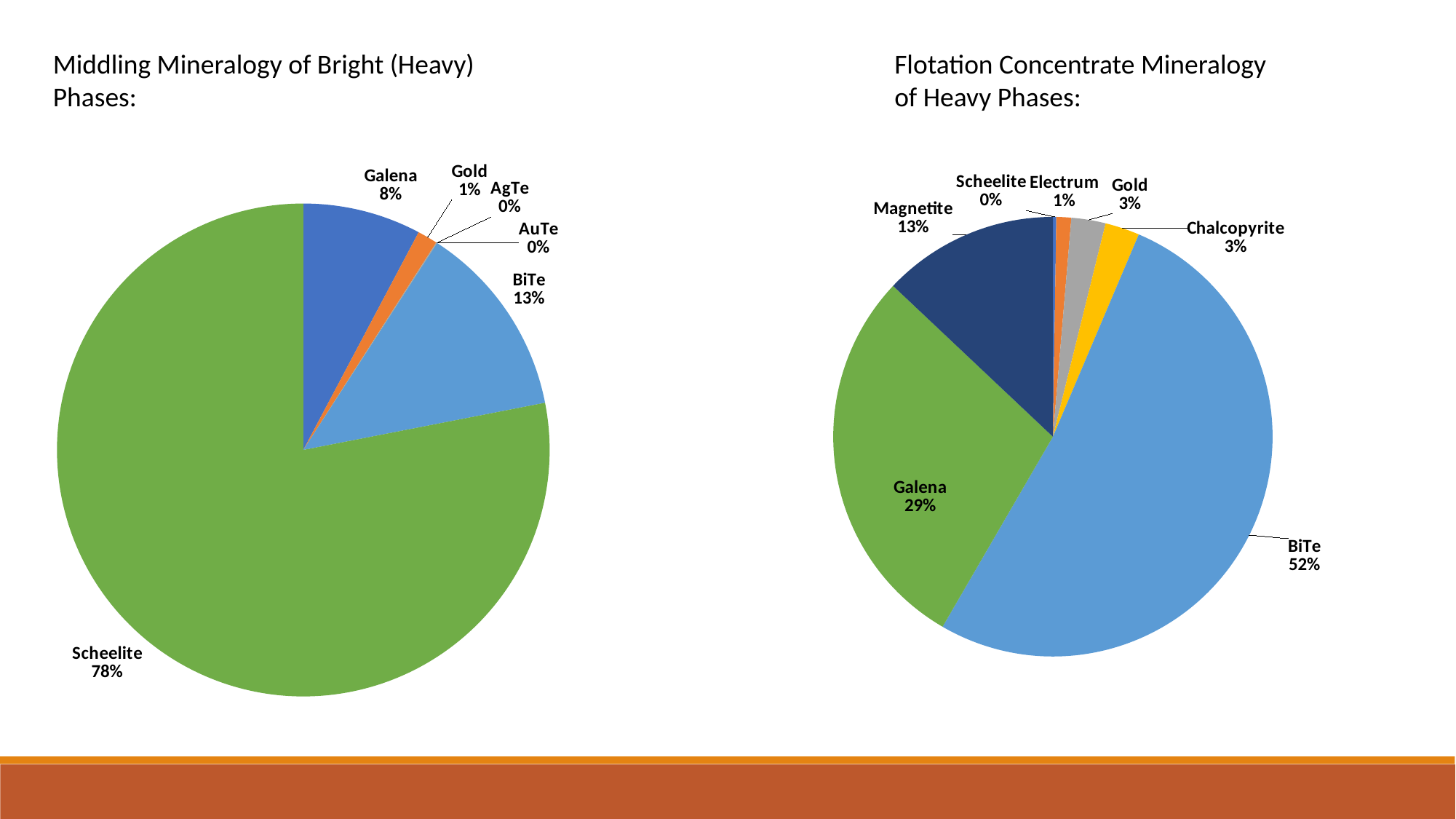
In the left pie chart (Middling Mineralogy of Bright (Heavy) Phases), how many slices are labelled? 6 In the left pie chart (Middling Mineralogy of Bright (Heavy) Phases), which mineral has the largest slice? Scheelite In the left pie chart (Middling Mineralogy of Bright (Heavy) Phases), what share does Galena have? 8% What type of chart is used on the left side of the slide? Pie chart In the right pie chart (Flotation Concentrate Mineralogy of Heavy Phases), what share does Magnetite have? 13% In the right pie chart (Flotation Concentrate Mineralogy of Heavy Phases), what is the difference between the BiTe share and the Galena share? 23% In the right pie chart (Flotation Concentrate Mineralogy of Heavy Phases), which is larger, the Magnetite share or the Gold share? Magnetite In the left pie chart (Middling Mineralogy of Bright (Heavy) Phases), what share does Scheelite have? 78% In the right pie chart (Flotation Concentrate Mineralogy of Heavy Phases), which mineral has the largest slice? BiTe